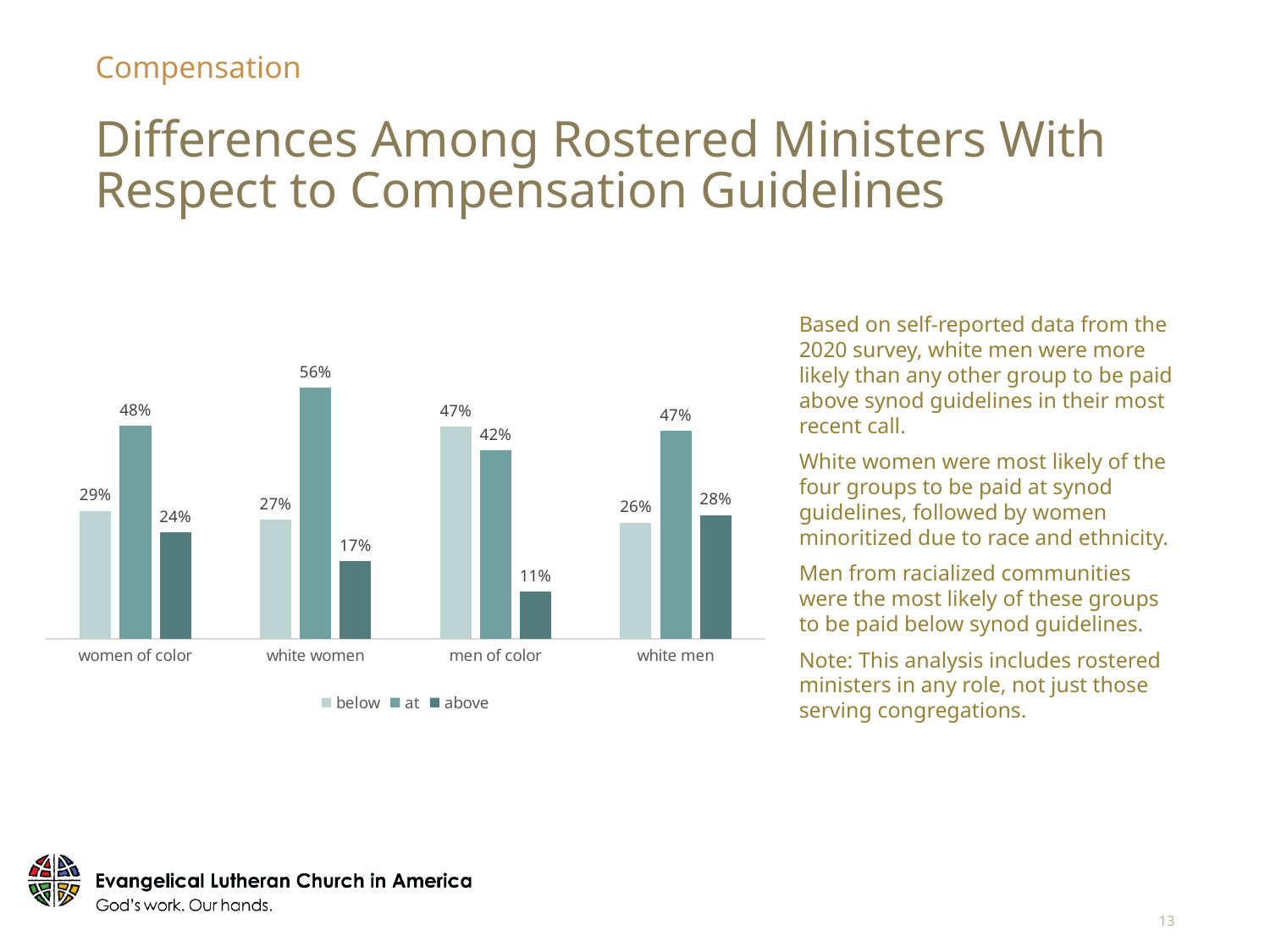
What is the value for 'above' for white men? 28% Which group has the highest 'above' value? white men What are the three series listed in the legend? below, at, above How many groups are shown on the x axis? 4 What kind of chart is shown on the slide? bar chart Which group has the highest 'at' value? white women What is the value for 'below' for men of color? 47% What is the difference between the 'at' and 'above' values for women of color? 24% What percentage of white women are paid at synod guidelines? 56% Which group has the lowest 'above' value? men of color Which is larger: the 'below' value for men of color or the 'below' value for white men? men of color How many series does the legend list? 3